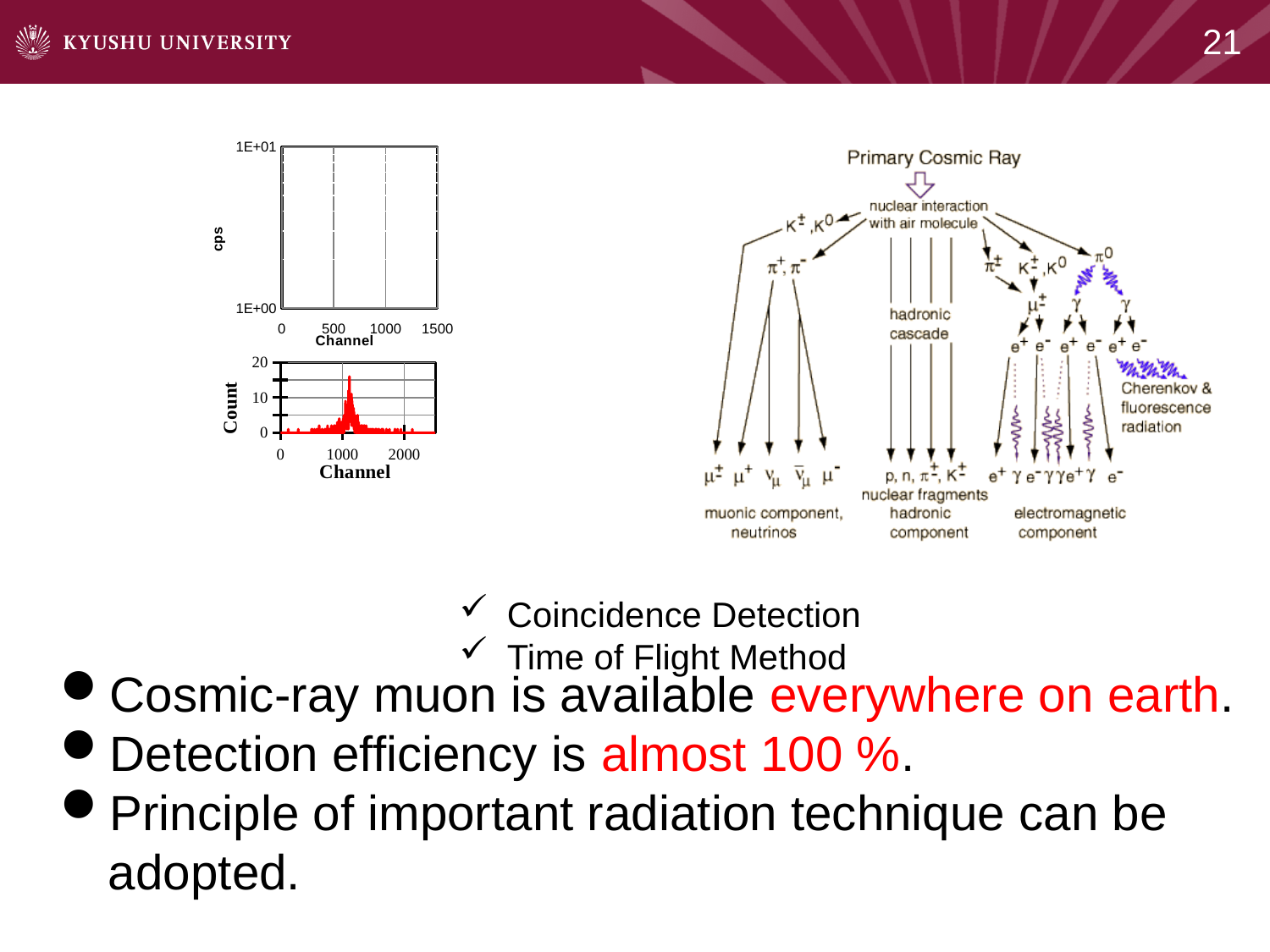
In the bottom chart, is the peak count greater or less than 20? less In the bottom chart, what is the label of the y axis? Count In the bottom chart, is the count at channel 2000 greater or less than 10? less In the top chart, what is the lowest tick value shown on the y axis? 1E+00 In the top chart, what is the label of the y axis? cps In the bottom chart, what is the label of the x axis? Channel In the bottom chart, is the peak count greater or less than 10? greater In the bottom chart, what is the highest tick value shown on the y axis? 20 In the top chart, what is the highest tick value shown on the y axis? 1E+01 In the top chart, what is the highest tick value shown on the x axis? 1500 In the bottom chart, what is the highest tick value shown on the x axis? 2000